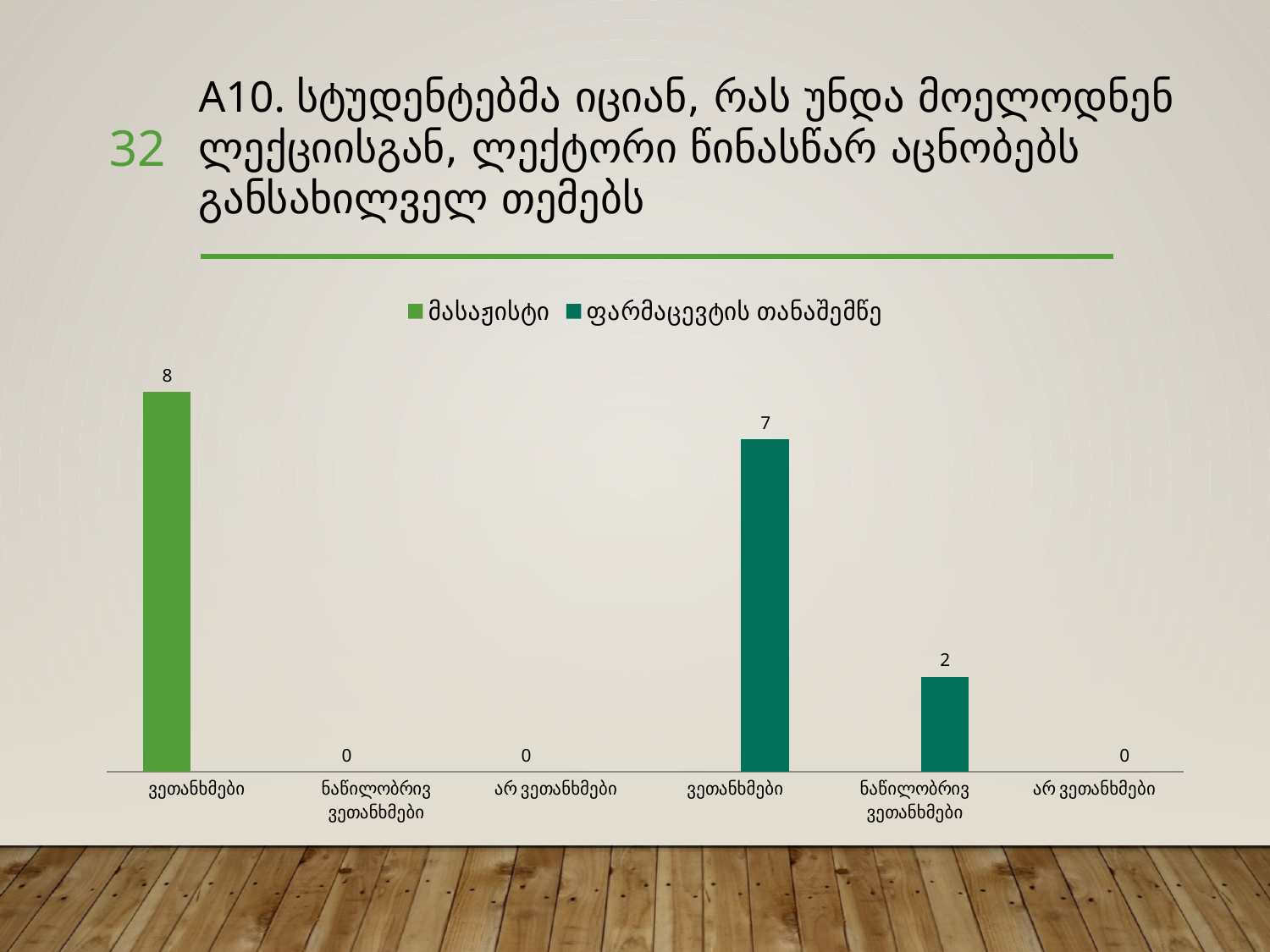
What is the value for ვეთანხმები in the მასაჟისტი series? 8 Which bar has the highest value on the chart? ვეთანხმები (მასაჟისტი) What is the value for არ ვეთანხმები in the მასაჟისტი series? 0 What is the value for ნაწილობრივ ვეთანხმები in the ფარმაცევტის თანაშემწე series? 2 What is the total of the three values in the ფარმაცევტის თანაშემწე series? 9 What type of chart is shown on the slide? bar chart Which is larger: ვეთანხმები for ფარმაცევტის თანაშემწე or ნაწილობრივ ვეთანხმები for ფარმაცევტის თანაშემწე? ვეთანხმები for ფარმაცევტის თანაშემწე What is the value for ვეთანხმები in the ფარმაცევტის თანაშემწე series? 7 How many series does the legend list? 2 How many bars are labelled with the value 0 on the chart? 3 Which series is shown in the lighter green colour in the legend? მასაჟისტი What is the difference between the ვეთანხმები values of the მასაჟისტი and ფარმაცევტის თანაშემწე series? 1